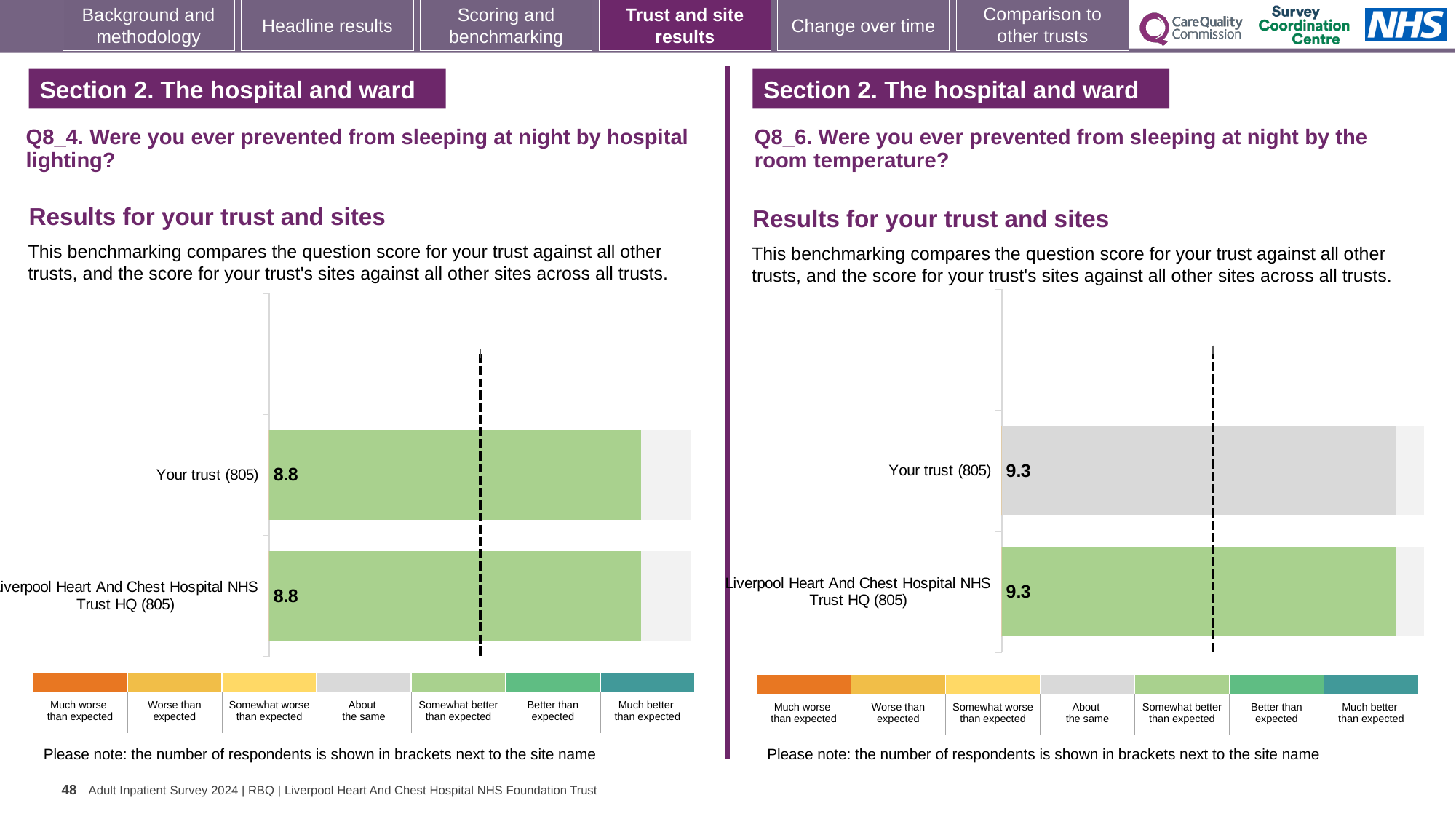
In the Q8_6 chart (room temperature), what is the score for Your trust (805)? 9.3 In the Q8_6 chart (room temperature), which benchmark category does the grey colour of the Your trust bar represent? About the same In the Q8_6 chart (room temperature), what is the score for Liverpool Heart And Chest Hospital NHS Trust HQ (805)? 9.3 In the Q8_6 chart (room temperature), what is the difference between the score for Your trust and the score for Liverpool Heart And Chest Hospital NHS Trust HQ? 0.0 In the Q8_4 chart (hospital lighting), what is the difference between the score for Your trust and the score for Liverpool Heart And Chest Hospital NHS Trust HQ? 0.0 In the Q8_4 chart (hospital lighting), what is the score for Your trust (805)? 8.8 What type of chart is used for the Q8_4 results (hospital lighting)? Bar chart How many bars are plotted in the Q8_6 chart (room temperature)? 2 In the Q8_4 chart (hospital lighting), what is the score for Liverpool Heart And Chest Hospital NHS Trust HQ (805)? 8.8 In the Q8_4 chart (hospital lighting), which benchmark category does the green colour of the Your trust bar represent? Somewhat better than expected How many benchmark categories does the colour key below the Q8_6 chart (room temperature) list? 7 How many bars are plotted in the Q8_4 chart (hospital lighting)? 2